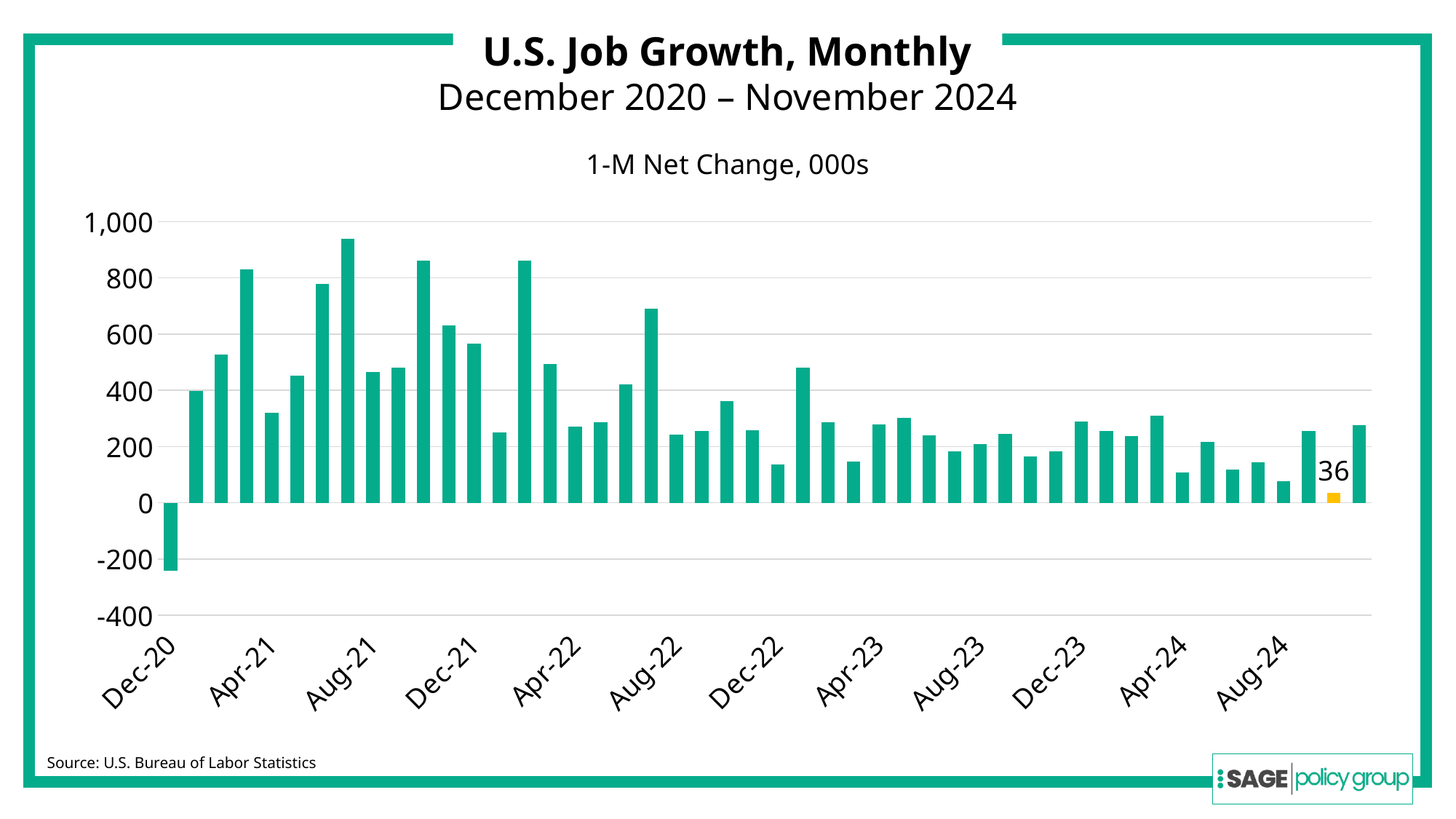
Is the value for Dec-21 greater or less than 400? greater Which of the labeled months, Aug-21 or Apr-24, has the larger value? Aug-21 Is the value for Apr-21 greater or less than 200? greater What value is printed on the orange highlighted bar near the right end of the chart? 36 What is the title of the chart? U.S. Job Growth, Monthly Do monthly job growth values generally rise or fall from 2021 to 2024? fall What kind of chart is shown on the slide? bar chart What unit label is shown above the chart? 1-M Net Change, 000s Is the value for Dec-20 greater or less than 0? less Which labeled month is the only one with a negative value? Dec-20